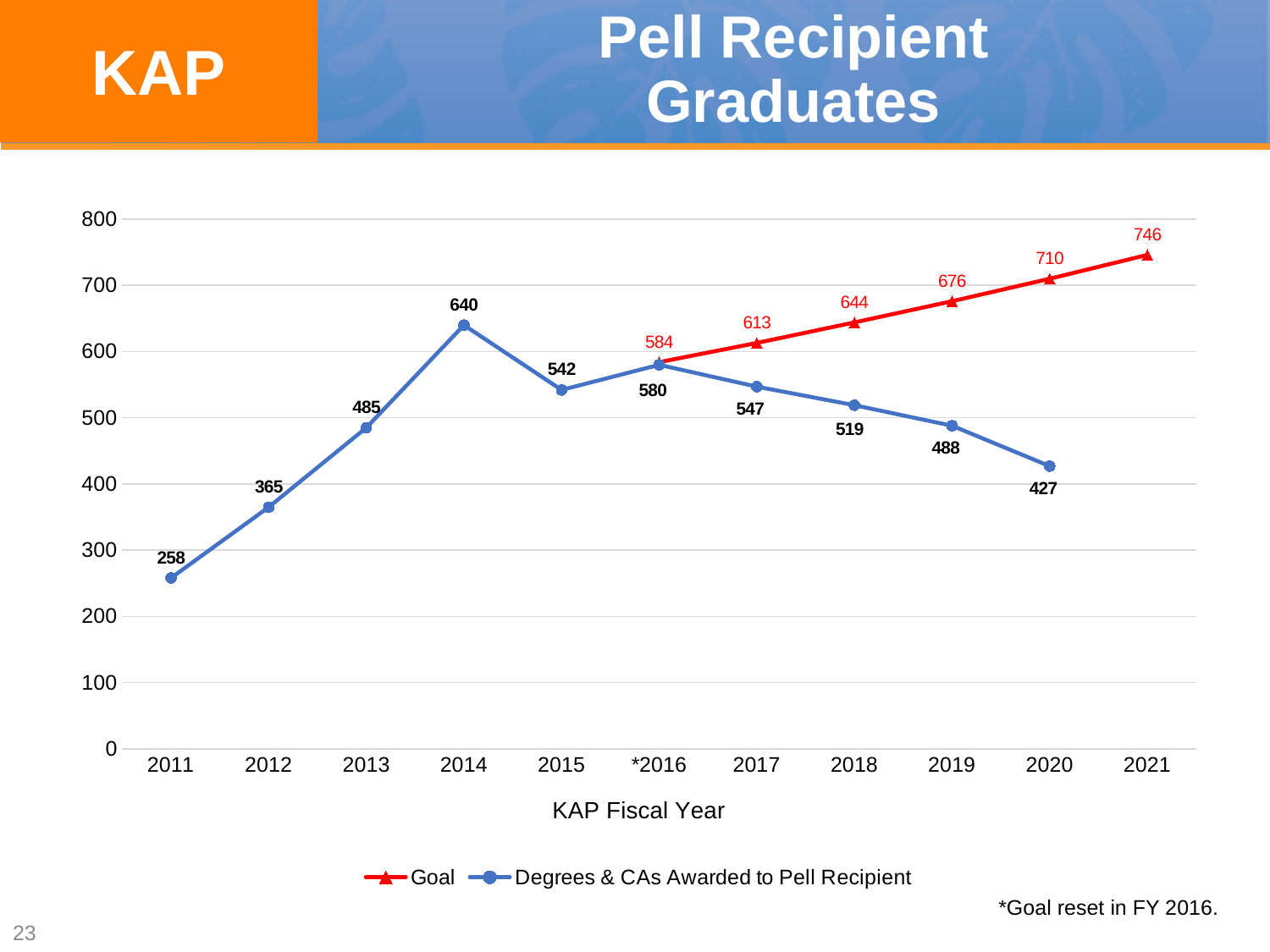
How many series does the legend list? 2 What is the Goal value for 2021? 746 What is the difference between the Goal and the Degrees & CAs Awarded to Pell Recipient in 2020? 283 Does the Goal series rise or fall from *2016 to 2021? Rise How many years are shown on the x axis? 11 What is the value of Degrees & CAs Awarded to Pell Recipient in 2014? 640 What is the x-axis title of the chart? KAP Fiscal Year Which is larger in 2018, the Goal or the Degrees & CAs Awarded to Pell Recipient? Goal What is the value of Degrees & CAs Awarded to Pell Recipient in 2020? 427 What kind of chart is this? Line chart In which year is the Degrees & CAs Awarded to Pell Recipient series lowest? 2011 In which year is the Degrees & CAs Awarded to Pell Recipient series highest? 2014